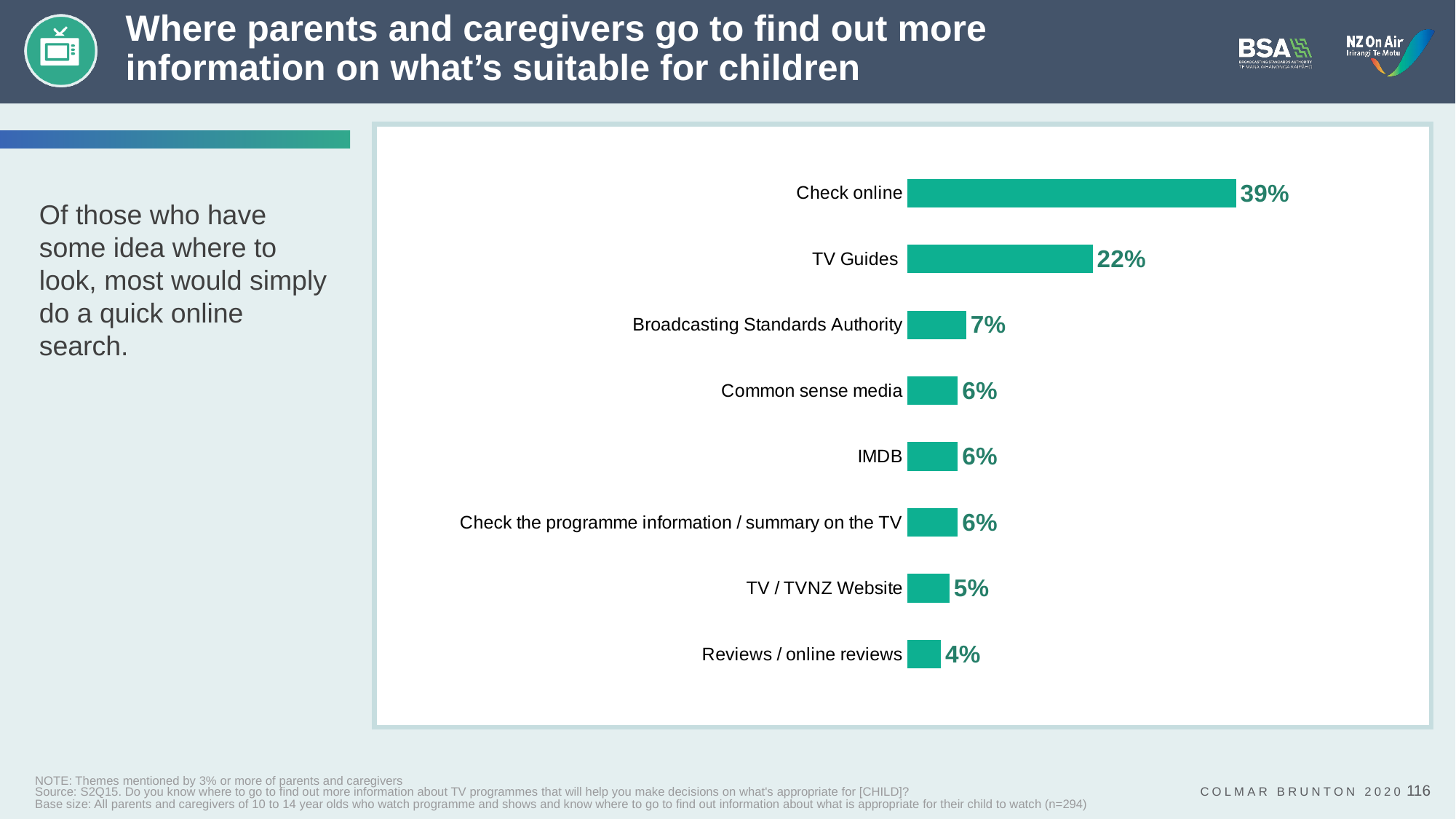
Which is larger, the value for Broadcasting Standards Authority or the value for TV / TVNZ Website? Broadcasting Standards Authority What is the value for Reviews / online reviews? 4% What is the value for TV / TVNZ Website? 5% How many categories share the value 6%? 3 What kind of chart is shown on the slide? Bar chart What is the value shown for TV Guides? 22% How many categories are shown in the chart? 8 What is the difference between the values for Check online and TV Guides? 17% Which category has the lowest value? Reviews / online reviews What percentage is shown for Broadcasting Standards Authority? 7% Which category has the highest value? Check online What percentage of parents and caregivers said they would check online? 39%